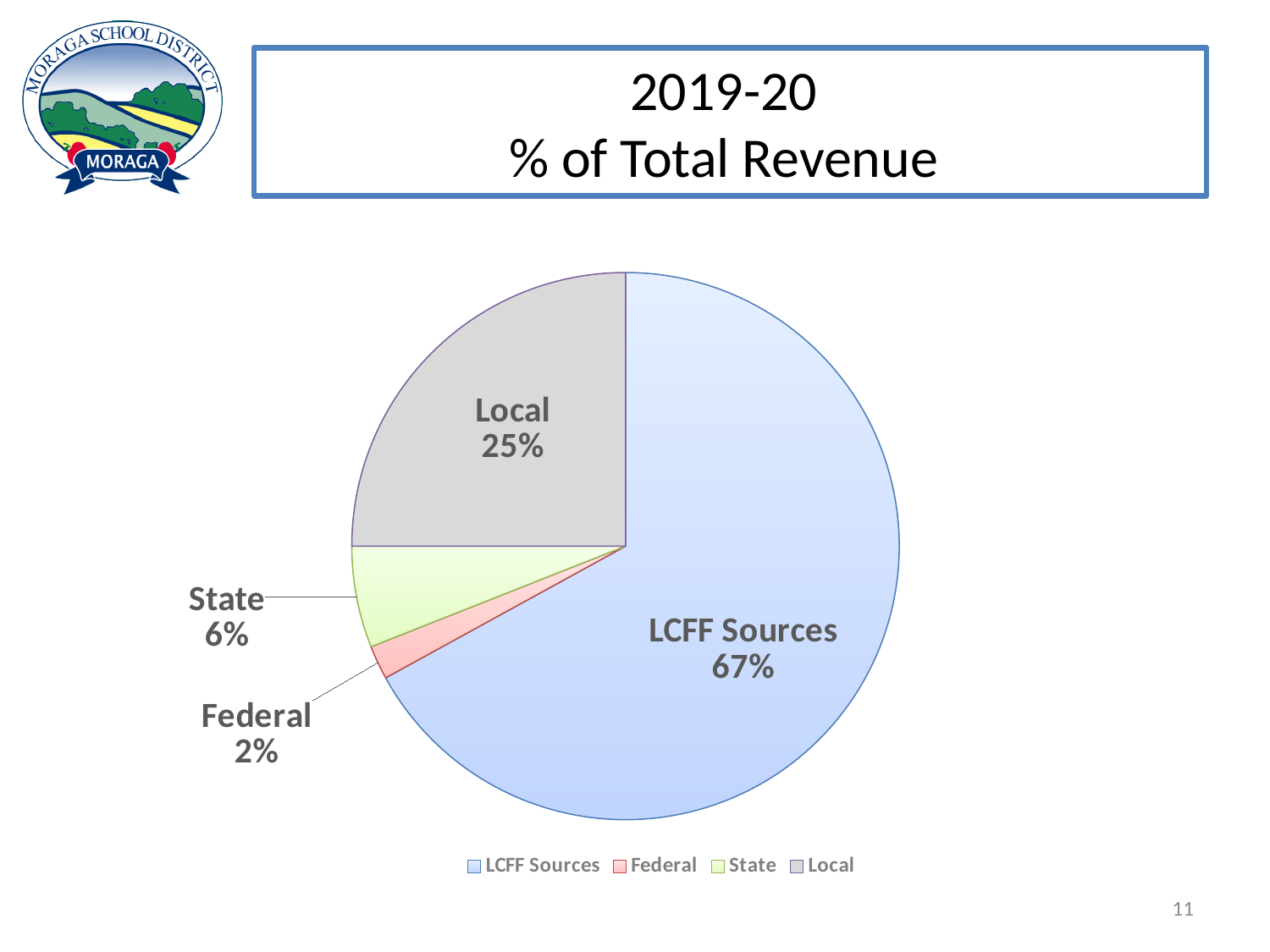
How many entries does the legend list? 4 What share of total revenue comes from Federal sources? 2% How many slices does the pie chart have? 4 Which revenue source has the largest share? LCFF Sources What share of total revenue comes from Local sources? 25% Which revenue source has the smallest share? Federal What is the title of the chart? 2019-20 % of Total Revenue What share of total revenue comes from State sources? 6% What is the difference in percentage points between the LCFF Sources share and the Local share? 42 Which is larger, the State share or the Federal share? State What kind of chart is shown on the slide? pie chart